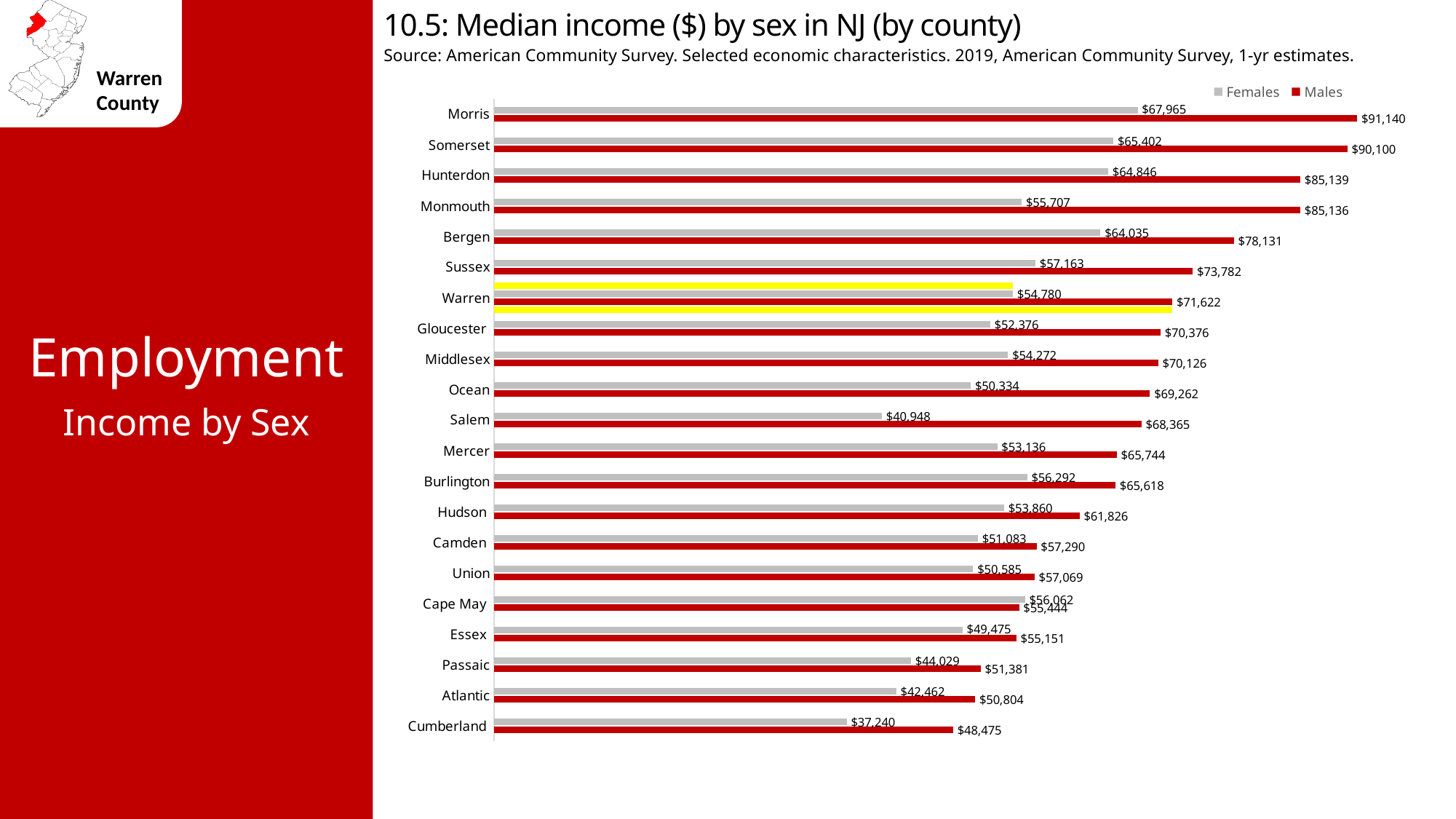
Which county has the lowest median income for females? Cumberland What is the median income for females in Salem County? $40,948 What is the difference between male and female median income in Warren County? $16,842 What is the median income for females in Warren County? $54,780 How many counties are shown in the chart? 21 What is the difference between male and female median income in Morris County? $23,175 How many series does the legend list? 2 In Cape May County, which is higher: the median income for females or for males? Females Which is larger: the median income for males in Hunterdon or in Monmouth? Hunterdon What type of chart is used on this slide? Bar chart Which county has the highest median income for males? Morris What is the median income for males in Warren County? $71,622